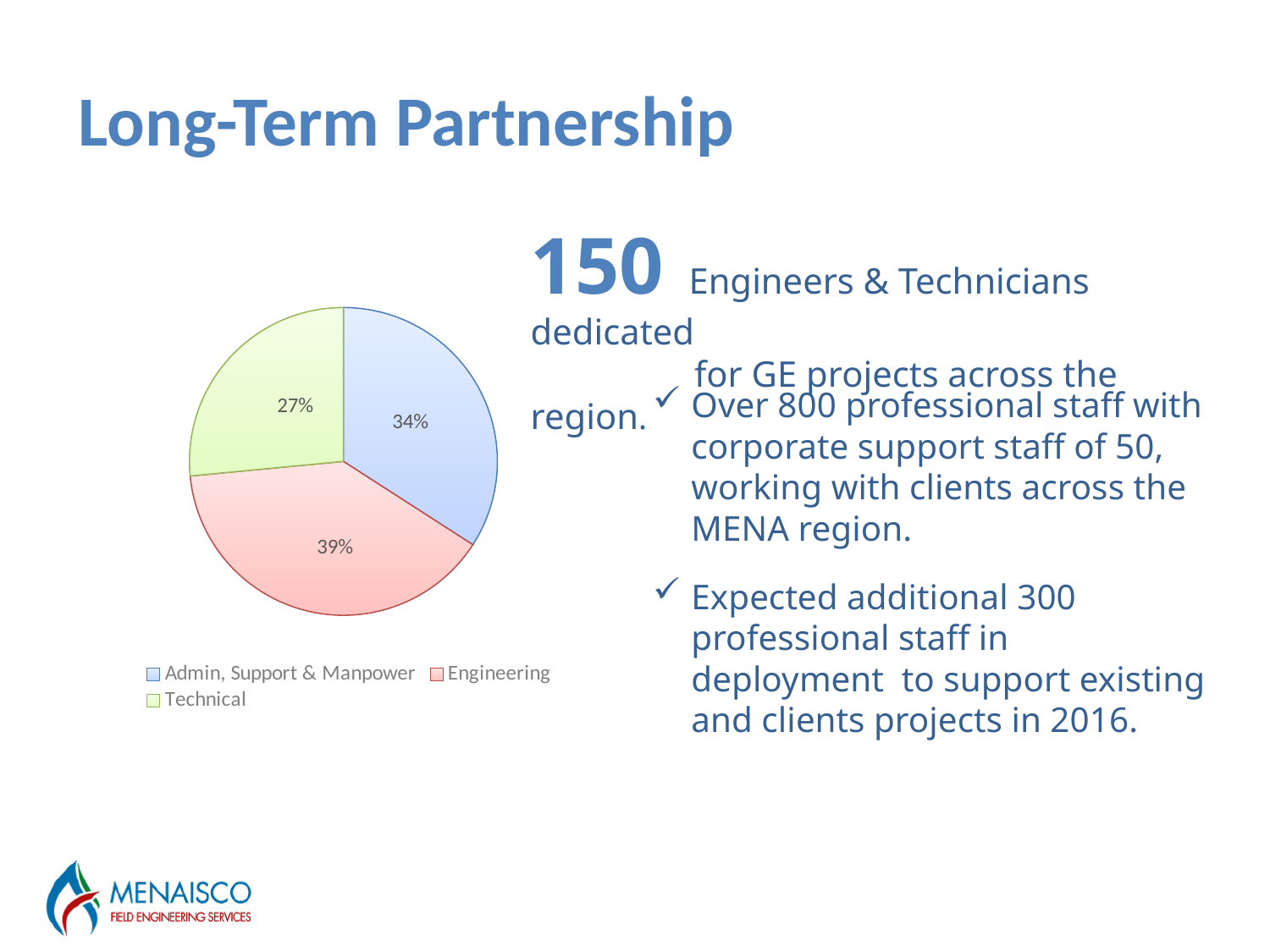
What share of the pie does Technical represent? 27% What kind of chart is shown on the slide? pie chart How many entries does the legend list? 3 Which category has the smallest slice of the pie? Technical Which category has the largest slice of the pie? Engineering What share of the pie does Admin, Support & Manpower represent? 34% What is the difference in percentage points between the Admin, Support & Manpower and Technical slices? 7 How many slices does the pie chart have? 3 What colour is the Engineering slice in the pie chart? red What is the difference in percentage points between the Engineering and Technical slices? 12 What share of the pie does Engineering represent? 39% Which is larger, the Admin, Support & Manpower slice or the Engineering slice? Engineering